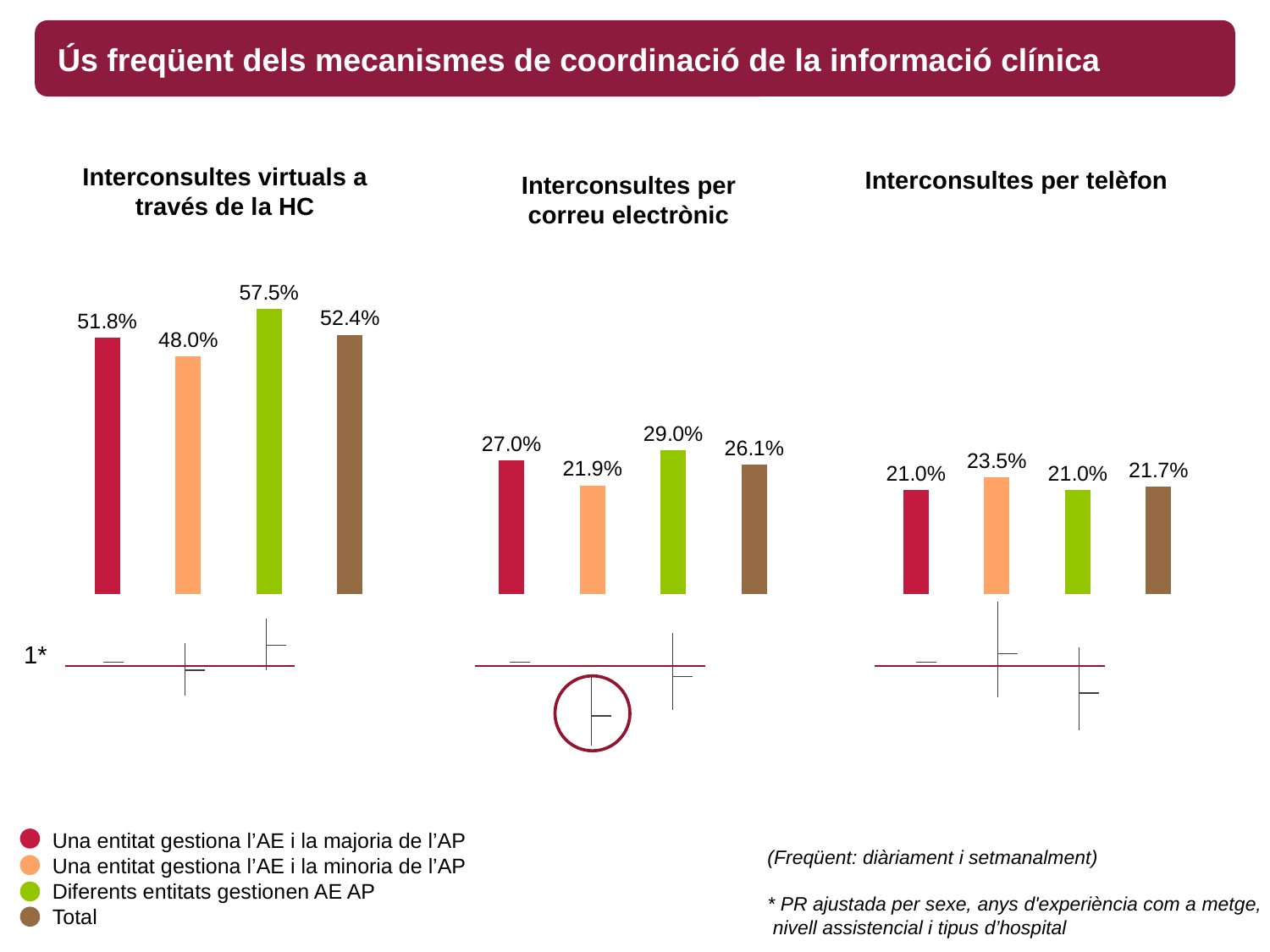
In the chart 'Interconsultes per correu electrònic', what is the value for 'Una entitat gestiona l'AE i la minoria de l'AP'? 21.9% In the chart 'Interconsultes virtuals a través de la HC', what is the value for 'Total'? 52.4% In the chart 'Interconsultes per correu electrònic', which category has the highest value? Diferents entitats gestionen AE AP In the chart 'Interconsultes per telèfon', which category has the highest value? Una entitat gestiona l'AE i la minoria de l'AP In the chart 'Interconsultes per correu electrònic', what is the difference between the values for 'Una entitat gestiona l'AE i la majoria de l'AP' and 'Total'? 0.9% In the chart 'Interconsultes per correu electrònic', which is larger: the value for 'Una entitat gestiona l'AE i la majoria de l'AP' or the value for 'Total'? Una entitat gestiona l'AE i la majoria de l'AP How many series does the legend list? 4 In the chart 'Interconsultes virtuals a través de la HC', what is the difference between the values for 'Diferents entitats gestionen AE AP' and 'Una entitat gestiona l'AE i la minoria de l'AP'? 9.5% What kind of chart is 'Interconsultes per telèfon'? Bar chart In the chart 'Interconsultes per telèfon', what is the value for 'Una entitat gestiona l'AE i la majoria de l'AP'? 21.0% In the chart 'Interconsultes virtuals a través de la HC', what is the value for 'Diferents entitats gestionen AE AP'? 57.5% In the chart 'Interconsultes virtuals a través de la HC', which category has the lowest value? Una entitat gestiona l'AE i la minoria de l'AP